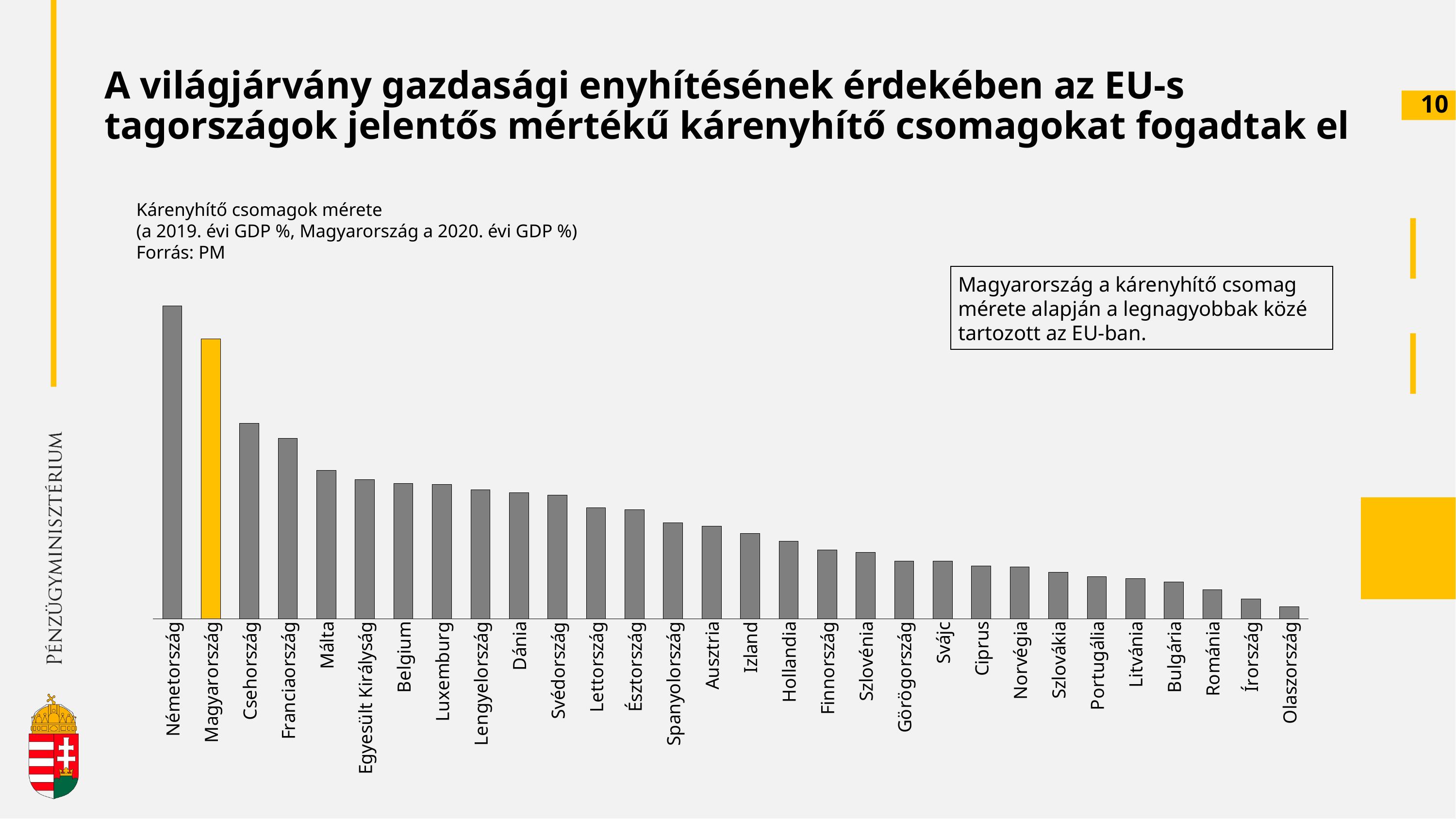
Do the bar values rise or fall from left to right along the x axis? fall Which has the larger value, Franciaország or Málta? Franciaország Which has the larger value, Ausztria or Hollandia? Ausztria Which country is second from the left in the chart? Magyarország How many countries are shown in the chart? 30 What kind of chart is shown on the slide? bar chart What is the source given for the chart? PM Which has the larger value, Magyarország or Csehország? Magyarország Which country has the highest bar in the chart? Németország Which country's bar is highlighted in yellow? Magyarország Which country has the lowest bar in the chart? Olaszország